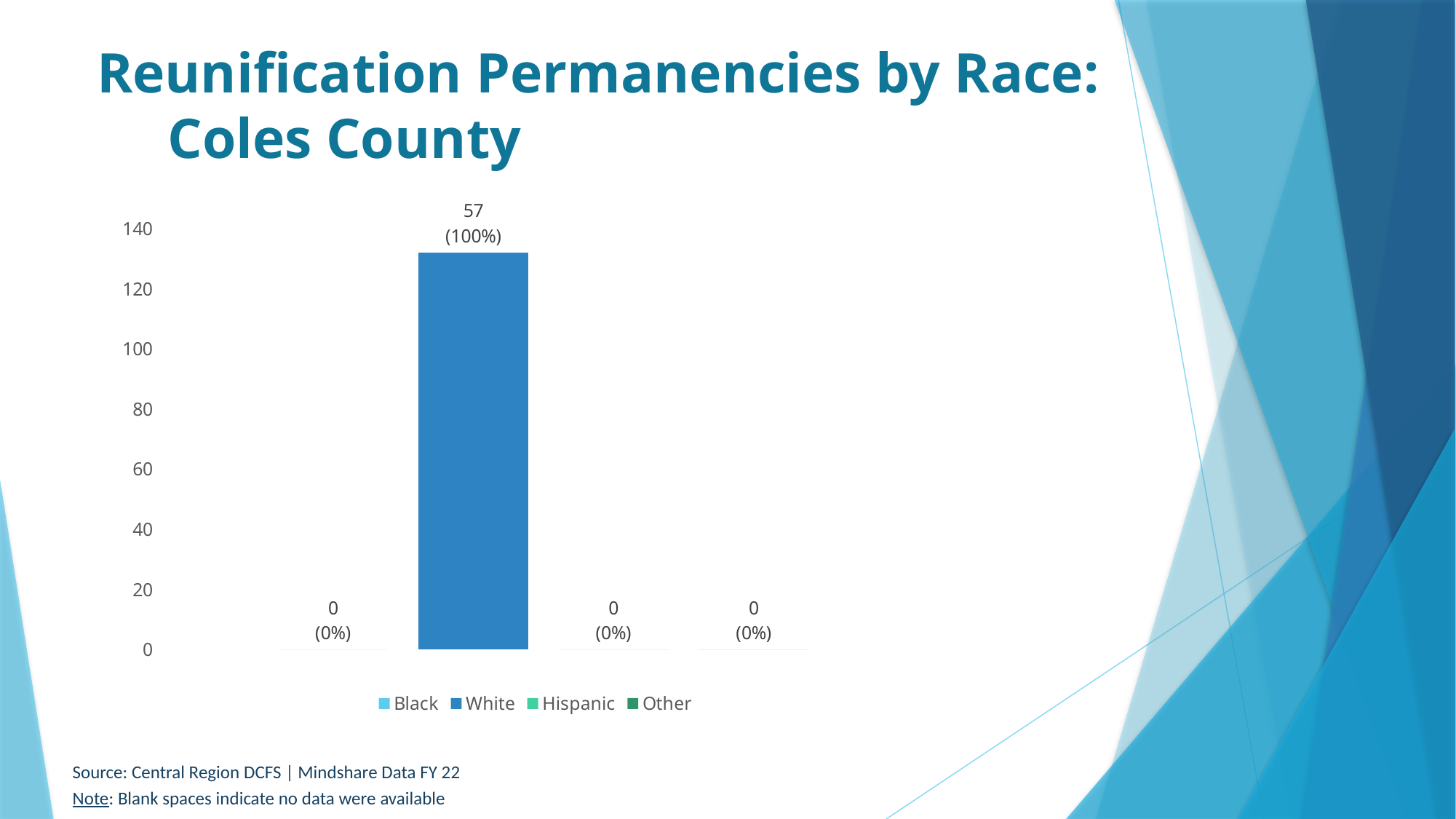
What is the difference between the values for White and Black? 57 What kind of chart is shown on the slide? Bar chart What percentage is shown for Other? 0% Which is larger, the value for White or the value for Hispanic? White What is the title of the slide? Reunification Permanencies by Race: Coles County What percentage is shown for White? 100% What is the value for White? 57 What is the value for Hispanic? 0 What is the source cited for the chart data? Central Region DCFS | Mindshare Data FY 22 Which category has the highest value? White What is the value for Black? 0 How many categories does the legend list? 4